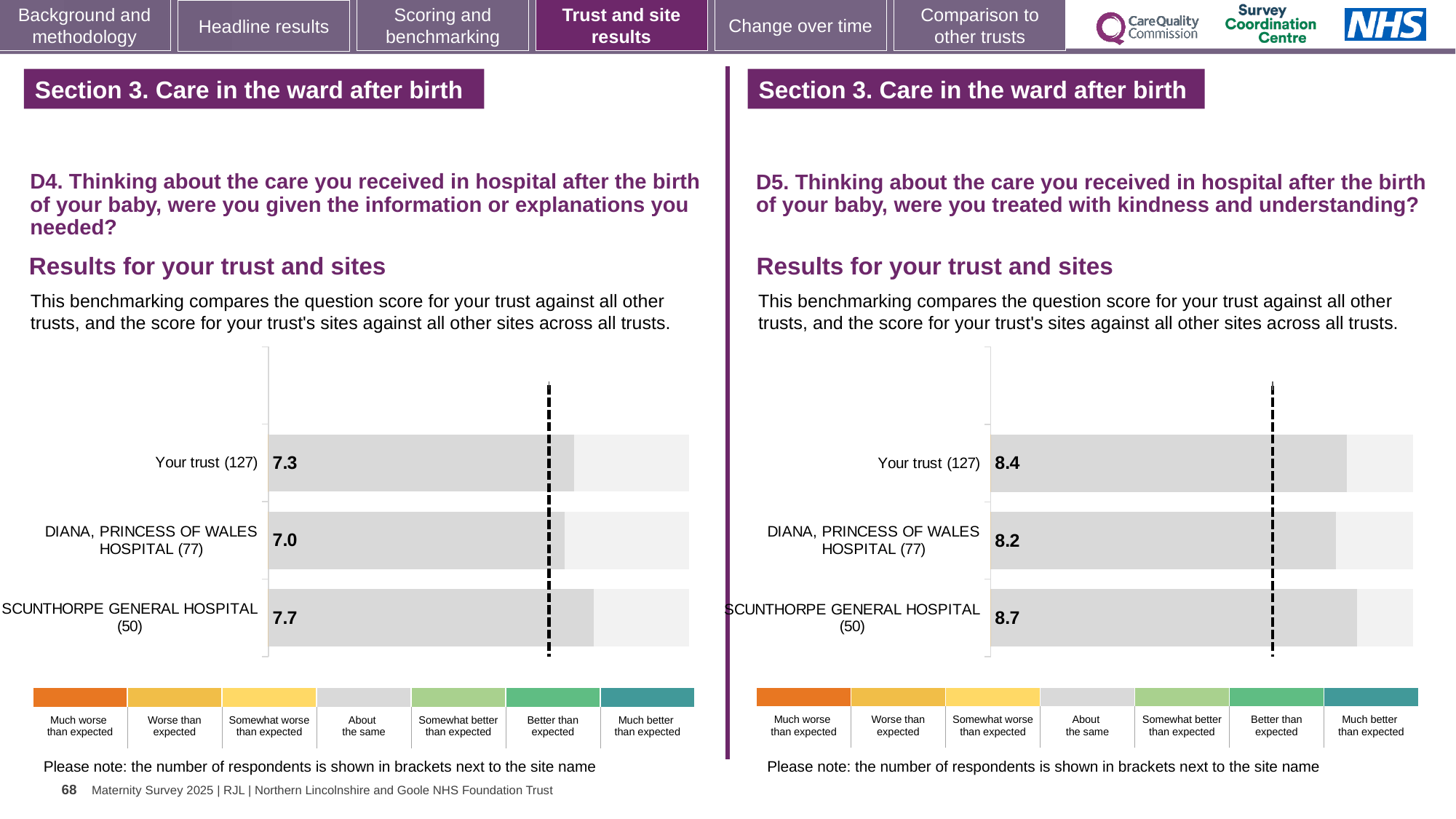
On the D5 chart (right), what is the score for Your trust (127)? 8.4 On the D5 chart (right), what is the score for DIANA, PRINCESS OF WALES HOSPITAL (77)? 8.2 On the D5 chart (right), what is the difference between the scores for SCUNTHORPE GENERAL HOSPITAL (50) and DIANA, PRINCESS OF WALES HOSPITAL (77)? 0.5 On the D5 chart (right), which has the larger score: Your trust (127) or DIANA, PRINCESS OF WALES HOSPITAL (77)? Your trust (127) On the D4 chart (left), what is the score for Your trust (127)? 7.3 How many bars are plotted on the D4 chart (left)? 3 On the D4 chart (left), which site or trust has the lowest score? DIANA, PRINCESS OF WALES HOSPITAL (77) On the D4 chart (left), what is the difference between the scores for SCUNTHORPE GENERAL HOSPITAL (50) and Your trust (127)? 0.4 What kind of chart is used on the D5 chart (right)? Bar chart On the D4 chart (left), which site or trust has the highest score? SCUNTHORPE GENERAL HOSPITAL (50) On the D4 chart (left), what is the score for SCUNTHORPE GENERAL HOSPITAL (50)? 7.7 On the D5 chart (right), which site or trust has the highest score? SCUNTHORPE GENERAL HOSPITAL (50)